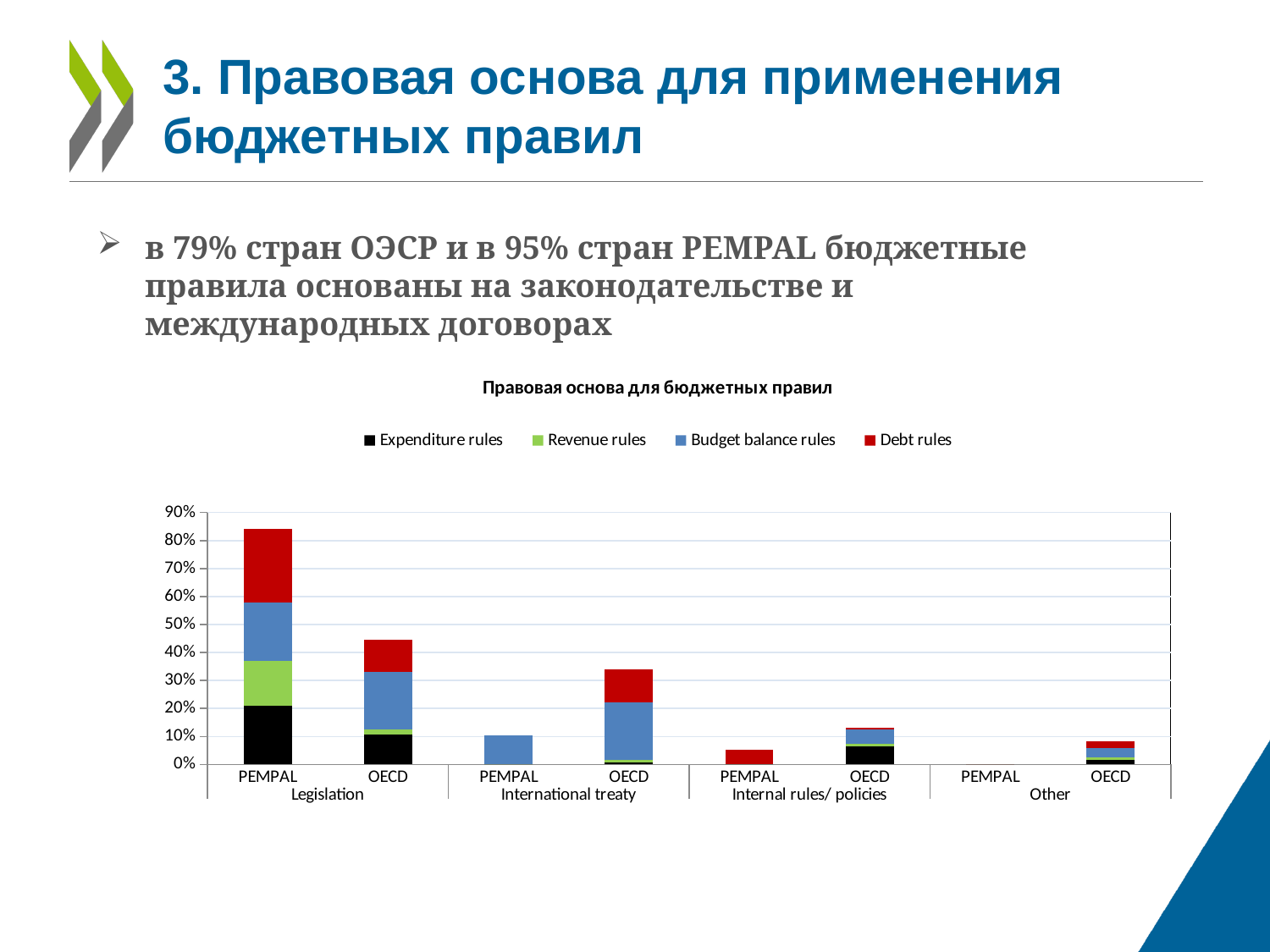
Under Legislation, which has the larger total, PEMPAL or OECD? PEMPAL Is the total for PEMPAL under Legislation greater or less than 70%? greater Under International treaty, which has the larger total, PEMPAL or OECD? OECD Which series is shown in red in the chart? Debt rules Is the total for OECD under Legislation greater or less than 50%? less Which bar has the highest total in the chart? PEMPAL, Legislation How many bars are plotted in the chart? 7 Is the total for OECD under International treaty greater or less than 20%? greater What kind of chart is shown on the slide? Stacked bar chart How many series does the chart legend list? 4 What is the title of the chart? Правовая основа для бюджетных правил